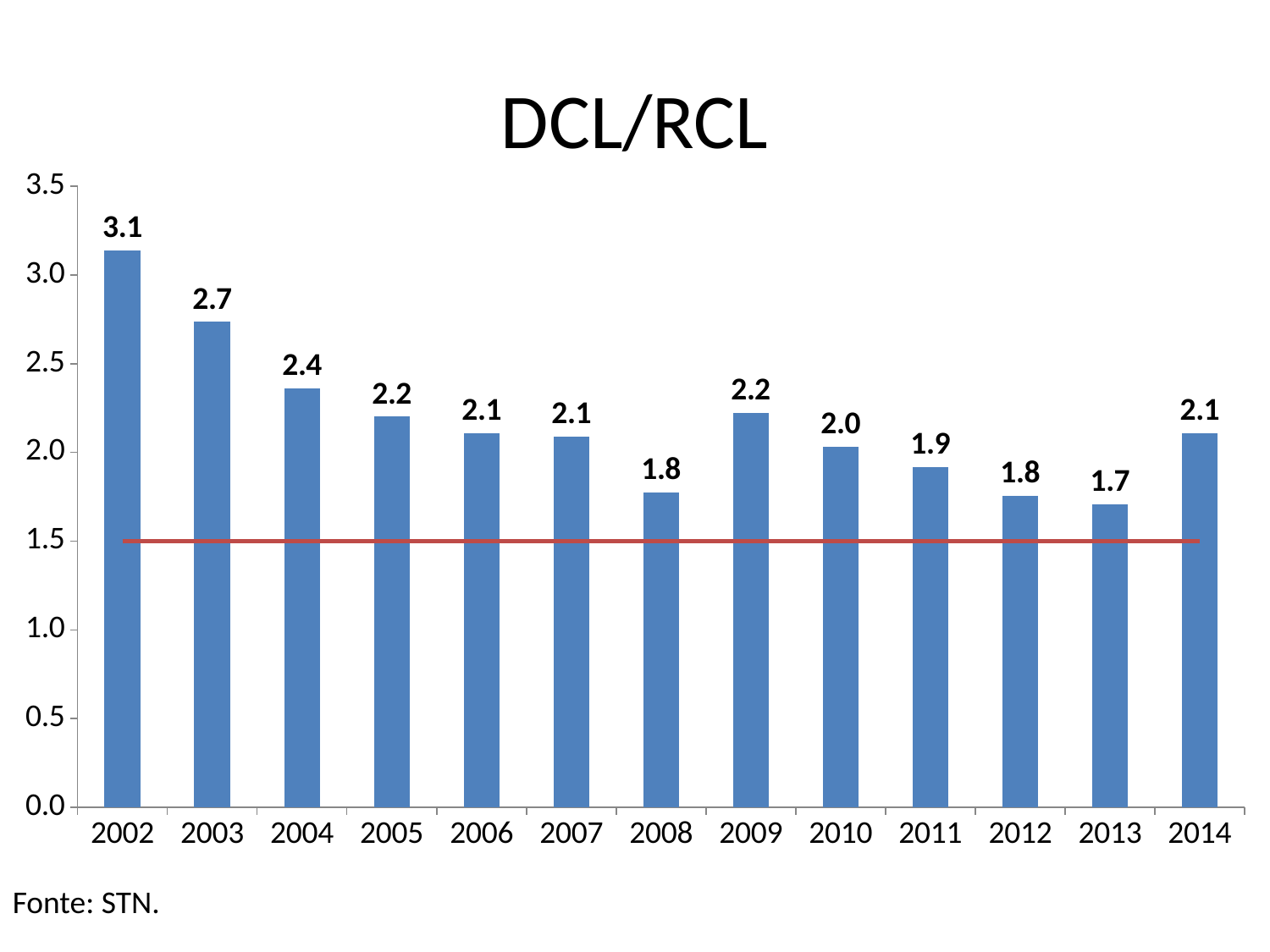
Is the DCL/RCL value for 2008 greater or less than 2.0? less What kind of chart is shown on the slide? bar chart What is the title of the chart? DCL/RCL What is the DCL/RCL value for 2009? 2.2 Which year has the highest DCL/RCL value? 2002 What is the DCL/RCL value for 2013? 1.7 Which year has the lowest DCL/RCL value? 2013 Does the DCL/RCL value rise or fall from 2002 to 2005? fall Which year has a larger DCL/RCL value, 2004 or 2010? 2004 How many years are shown on the x axis of the chart? 13 What is the difference between the DCL/RCL values for 2002 and 2003? 0.4 What is the DCL/RCL value for 2002? 3.1